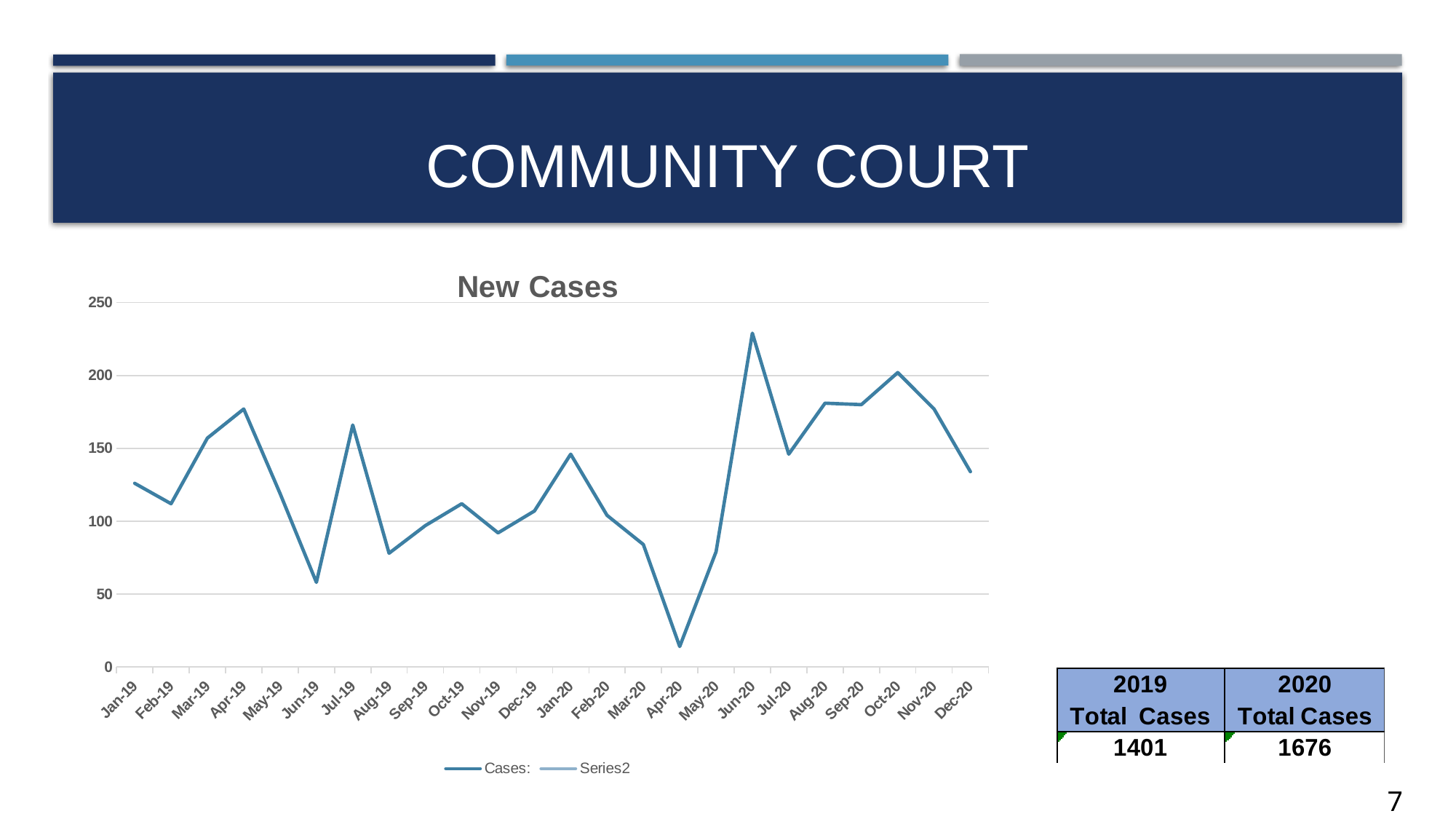
What kind of chart is shown on the slide? line chart Do the values rise or fall from Apr-20 to Jun-20? rise Which month has the higher value, Jun-20 or Apr-19? Jun-20 In which month does the New Cases line reach its lowest point? Apr-20 Is the value for Apr-19 greater or less than 150? greater How many monthly data points are plotted along the x axis? 24 Is the value for Jun-20 greater or less than 200? greater How many series does the chart legend list? 2 What is the title of the chart? New Cases In which month does the New Cases line reach its highest point? Jun-20 Is the value for Aug-19 greater or less than 100? less